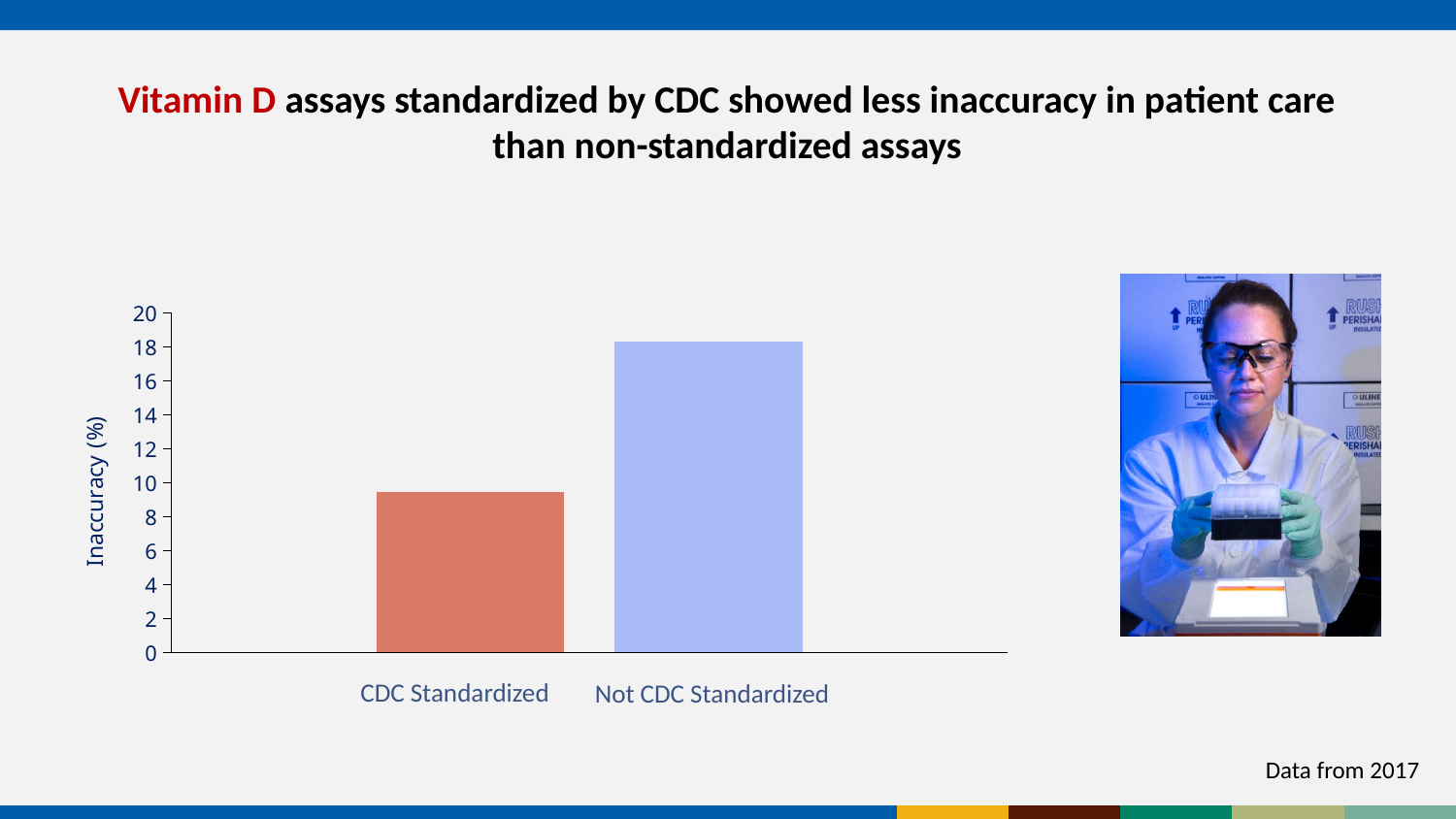
How many categories are plotted in the chart? 2 What colour is the bar for CDC Standardized? orange-red Which has a larger value, CDC Standardized or Not CDC Standardized? Not CDC Standardized Is the value for Not CDC Standardized greater or less than 20? less Which category has the highest inaccuracy? Not CDC Standardized Is the value for CDC Standardized greater or less than 8? greater What is the label on the y axis of the chart? Inaccuracy (%) Is the value for Not CDC Standardized greater or less than 16? greater Which category has the lowest inaccuracy? CDC Standardized What is the maximum value shown on the y axis? 20 What kind of chart is shown on the slide? bar chart